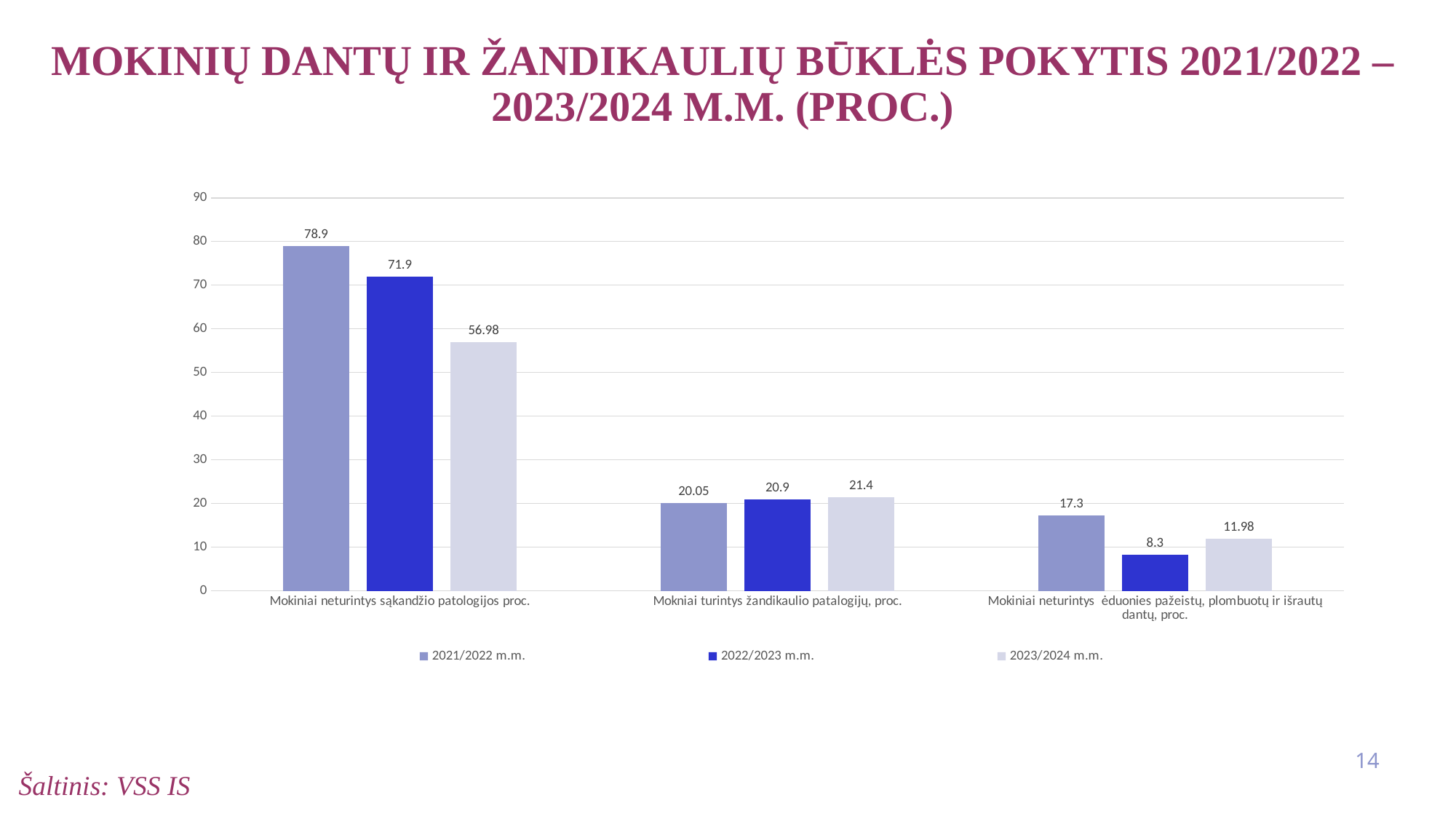
Do the values for 'Mokiniai neturintys sąkandžio patologijos proc.' rise or fall from 2021/2022 m.m. to 2023/2024 m.m.? fall Which series has the lowest value for 'Mokiniai neturintys ėduonies pažeistų, plombuotų ir išrautų dantų, proc.'? 2022/2023 m.m. What kind of chart is shown on the slide? bar chart Which series has the highest value for 'Mokiniai neturintys sąkandžio patologijos proc.'? 2021/2022 m.m. How many series does the legend list? 3 What is the value for 'Mokiniai neturintys sąkandžio patologijos proc.' in 2021/2022 m.m.? 78.9 How many categories are shown on the x axis? 3 What is the value for 'Mokiniai neturintys sąkandžio patologijos proc.' in 2023/2024 m.m.? 56.98 What is the value for 'Mokiniai neturintys ėduonies pažeistų, plombuotų ir išrautų dantų, proc.' in 2023/2024 m.m.? 11.98 Which is larger: the 2021/2022 m.m. value for 'Mokiniai neturintys ėduonies pažeistų, plombuotų ir išrautų dantų, proc.' or the 2023/2024 m.m. value for the same category? 2021/2022 m.m. What is the value for 'Mokniai turintys žandikaulio patalogijų, proc.' in 2022/2023 m.m.? 20.9 What is the difference between the 2021/2022 m.m. and 2022/2023 m.m. values for 'Mokiniai neturintys sąkandžio patologijos proc.'? 7